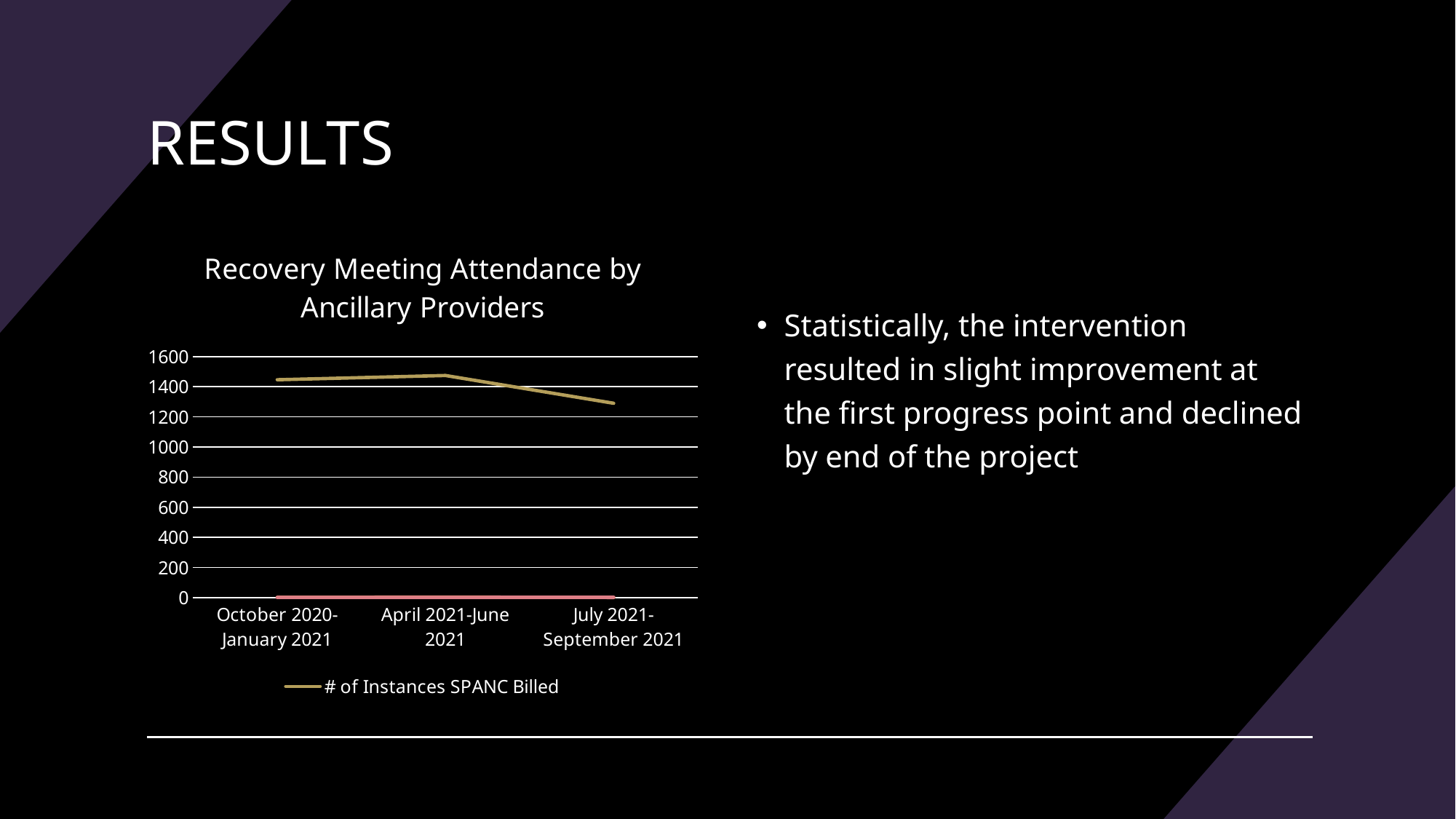
Which time period has the lowest value for # of Instances SPANC Billed? July 2021-September 2021 What kind of chart is shown on the slide? line chart How many series does the chart legend list? 1 How many time periods are shown on the x axis of the chart? 3 Is the value for # of Instances SPANC Billed in July 2021-September 2021 greater or less than 1400? less What is the title of the chart? Recovery Meeting Attendance by Ancillary Providers Is the value for # of Instances SPANC Billed in July 2021-September 2021 greater or less than 1200? greater Which is larger, the value for # of Instances SPANC Billed in April 2021-June 2021 or in July 2021-September 2021? April 2021-June 2021 Is the value for # of Instances SPANC Billed in April 2021-June 2021 greater or less than 1400? greater How does the # of Instances SPANC Billed change across the three time periods from left to right? rises slightly, then falls What series name is shown in the chart legend? # of Instances SPANC Billed